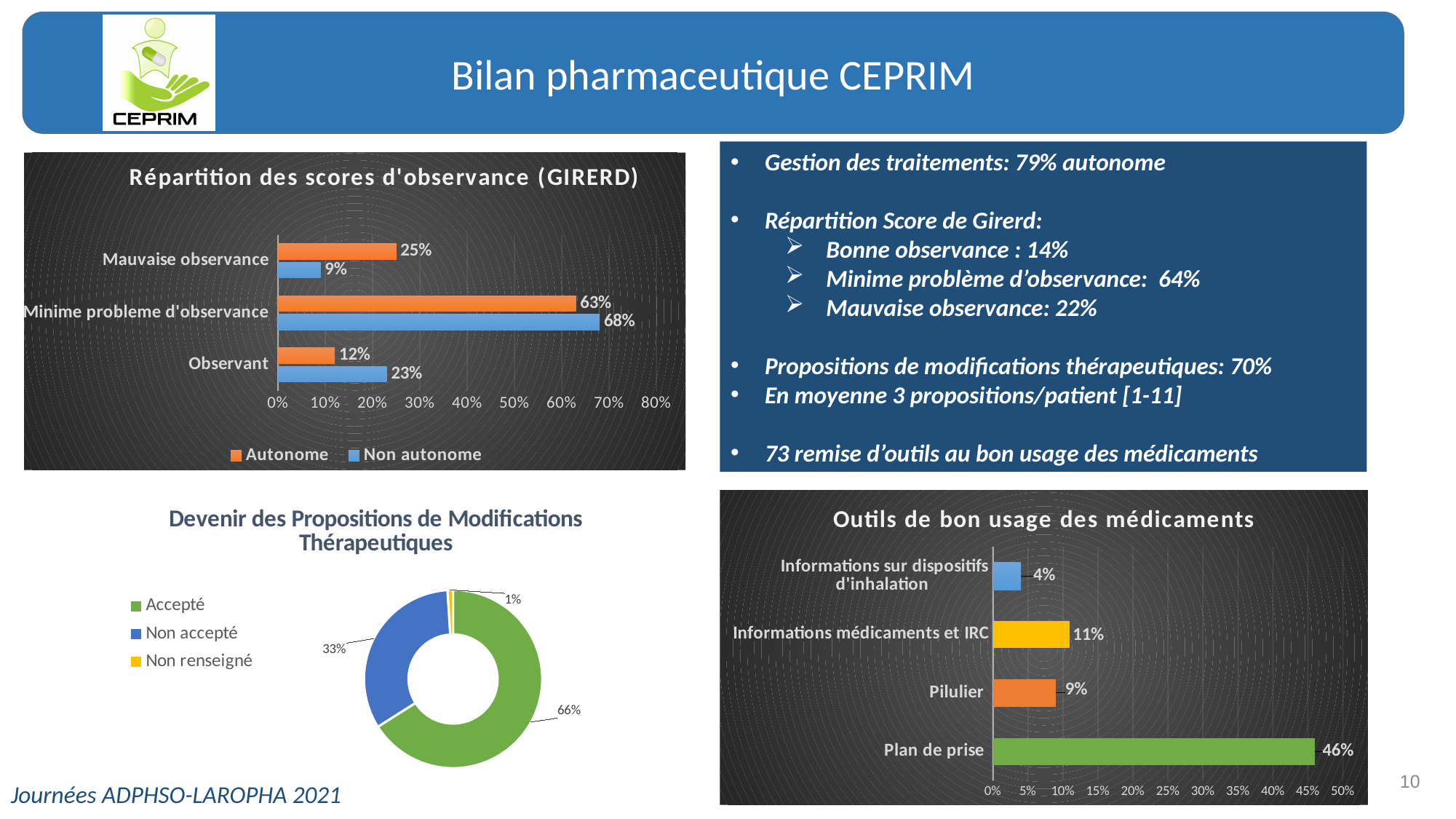
In the chart 'Devenir des Propositions de Modifications Thérapeutiques', what share is Non accepté? 33% In the chart 'Répartition des scores d'observance (GIRERD)', what is the difference between the Non autonome and Autonome values for Minime probleme d'observance? 5% In the chart 'Répartition des scores d'observance (GIRERD)', what is the Autonome value for Mauvaise observance? 25% In the chart 'Répartition des scores d'observance (GIRERD)', which is larger for Observant: Autonome or Non autonome? Non autonome In the chart 'Outils de bon usage des médicaments', what is the difference between Informations médicaments et IRC and Pilulier? 2% In the chart 'Devenir des Propositions de Modifications Thérapeutiques', which category has the smallest share? Non renseigné What kind of chart is 'Devenir des Propositions de Modifications Thérapeutiques'? Doughnut chart In the chart 'Outils de bon usage des médicaments', what is the value for Plan de prise? 46% In the chart 'Répartition des scores d'observance (GIRERD)', how many series does the legend list? 2 In the chart 'Répartition des scores d'observance (GIRERD)', which category has the highest Non autonome value? Minime probleme d'observance In the chart 'Répartition des scores d'observance (GIRERD)', what is the Non autonome value for Observant? 23% In the chart 'Outils de bon usage des médicaments', how many categories are shown? 4